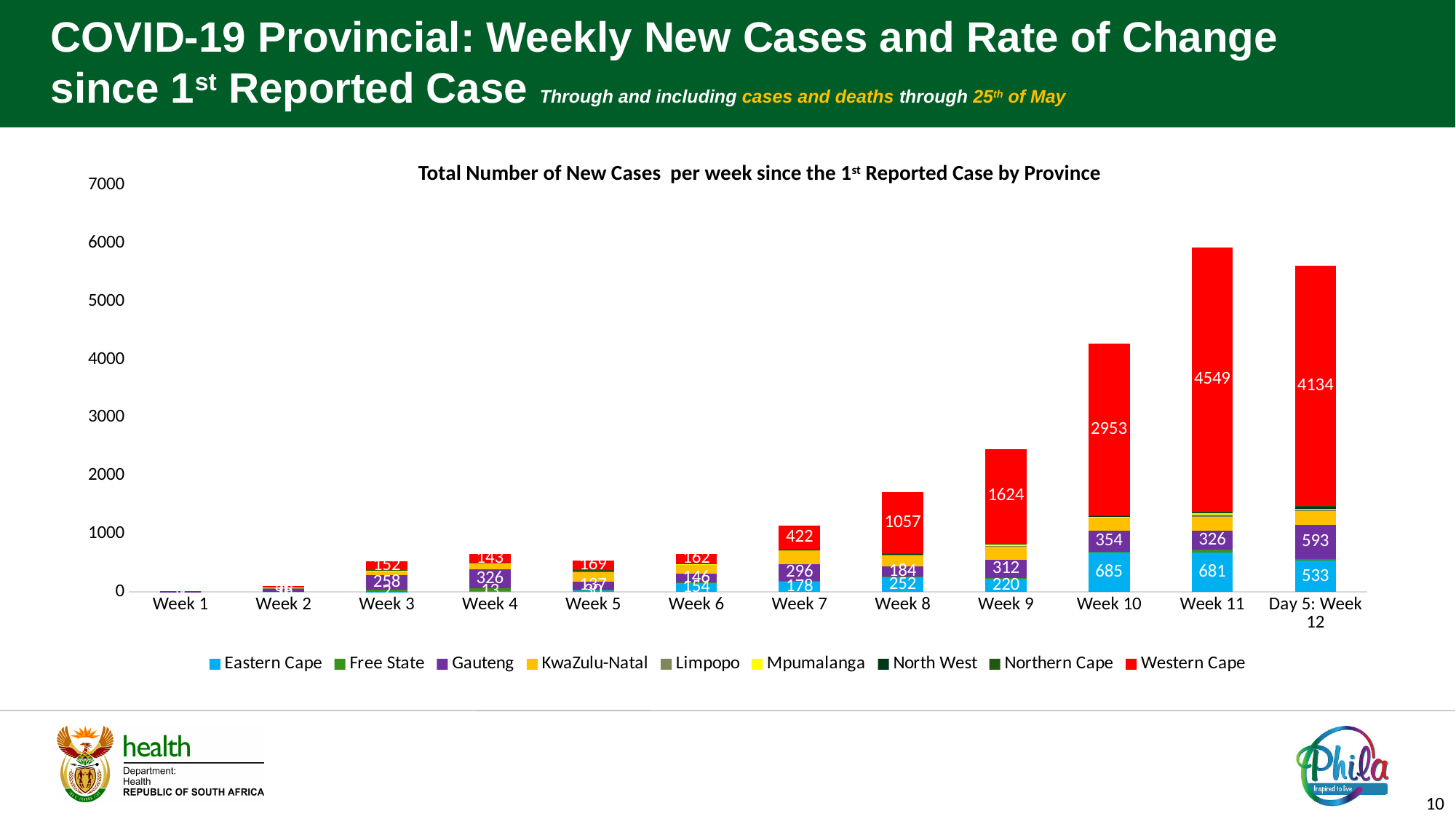
Do Western Cape's weekly new cases rise or fall from Week 7 to Week 11? rise Is the total bar for Week 10 greater or less than 4000? greater How many provinces are listed in the chart legend? 9 What is the number of new cases for Western Cape in Week 11? 4549 What is the number of new cases for Eastern Cape in Week 10? 685 What is the number of new cases for Gauteng in Day 5: Week 12? 593 What is the difference between Western Cape's new cases in Week 11 and in Day 5: Week 12? 415 What is the number of new cases for Western Cape in Week 8? 1057 How many week categories are shown along the x axis? 12 What kind of chart is shown on the slide? Stacked bar chart Which is larger, Eastern Cape's new cases in Week 10 or in Week 11? Week 10 Which week has the tallest total bar? Week 11